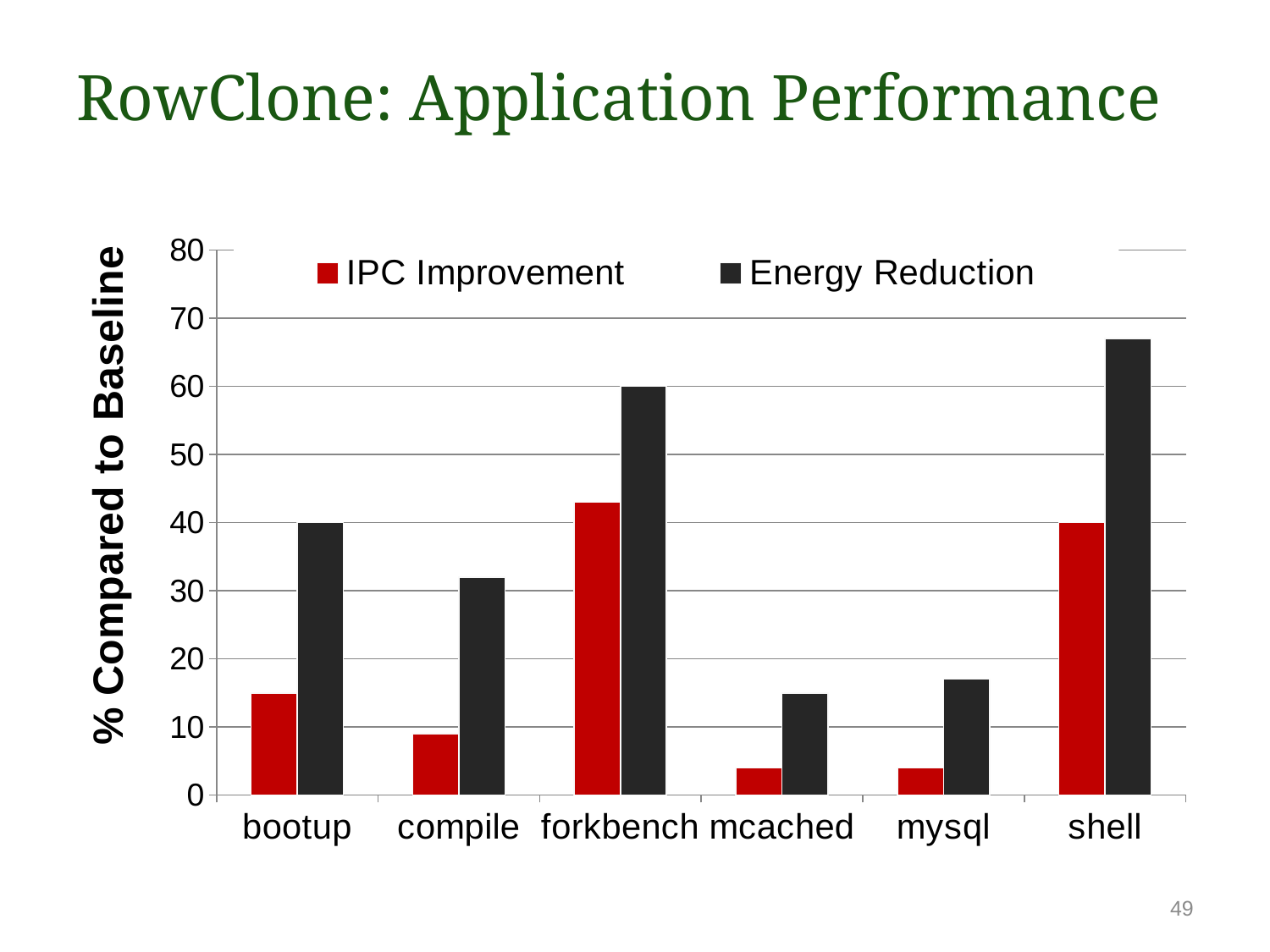
What kind of chart is shown on the slide? bar chart What is the Energy Reduction value for bootup? 40 Which is larger, the Energy Reduction for bootup or for compile? bootup How many application categories are shown on the x axis? 6 Is the Energy Reduction for shell greater or less than 60? greater Is the IPC Improvement for compile greater or less than 10? less Is the Energy Reduction for mysql greater or less than 20? less How many series does the legend list? 2 What is the label of the y axis? % Compared to Baseline Which application has the highest IPC Improvement? forkbench Which application has the highest Energy Reduction? shell What is the Energy Reduction value for forkbench? 60